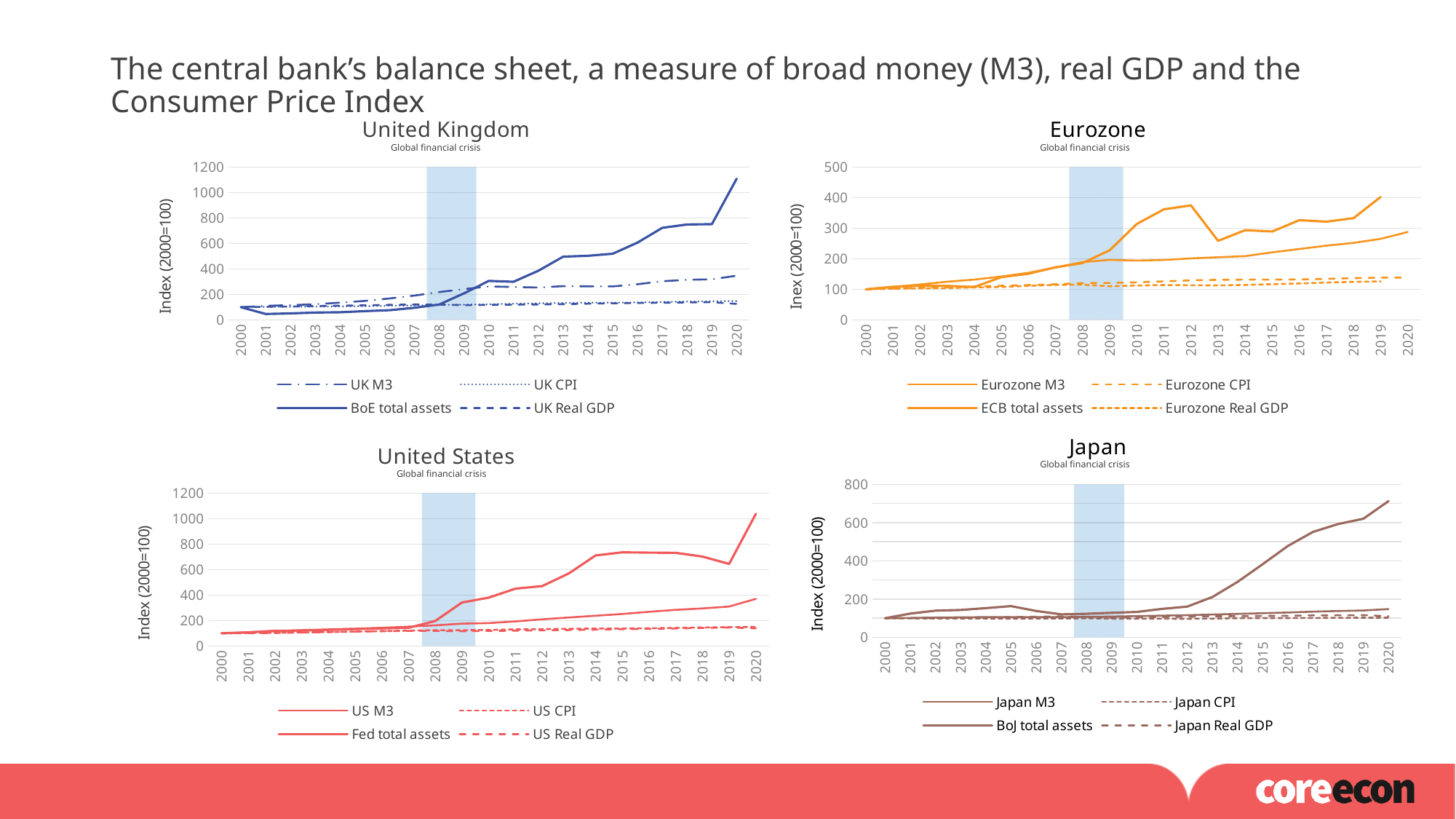
In the United Kingdom chart, is the value for BoE total assets in 2020 greater or less than 1000? greater In the Eurozone chart, is the value for Eurozone CPI in 2020 greater or less than 200? less How many series does the legend of the United Kingdom chart list? 4 How many years are shown on the x axis of the United States chart? 21 In the Eurozone chart, is the value for ECB total assets in 2019 greater or less than 300? greater What kind of chart is the United Kingdom chart? Line chart In the Japan chart, do the values for BoJ total assets rise or fall from 2012 to 2020? rise In the United States chart, which is higher in 2020, Fed total assets or US M3? Fed total assets What is the y-axis label of the United States chart? Index (2000=100) What event does the shaded band on each chart mark? Global financial crisis